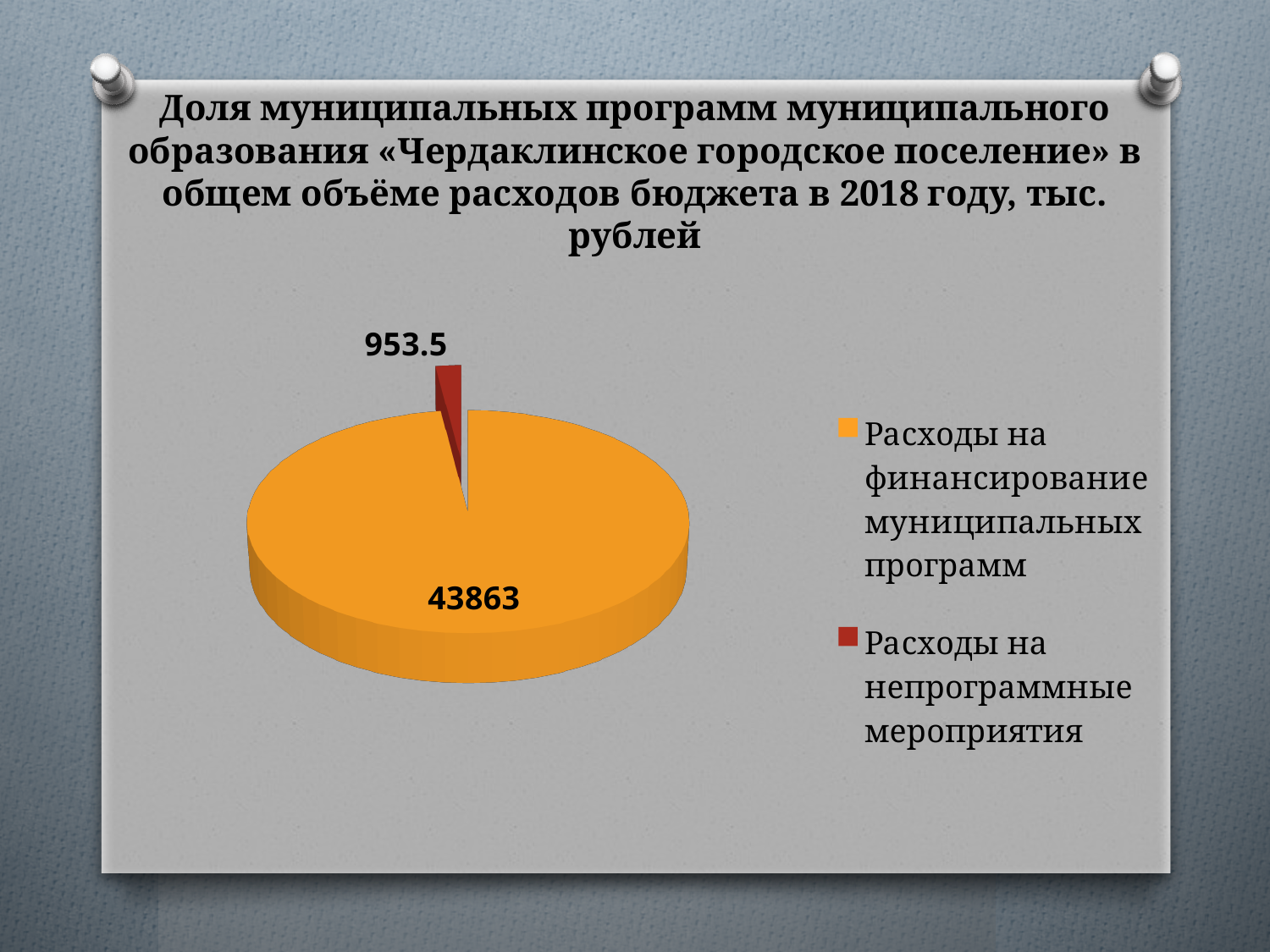
What is the total of the two values shown on the pie chart? 44816.5 Which is larger: the value for "Расходы на непрограммные мероприятия" or the value for "Расходы на финансирование муниципальных программ"? Расходы на финансирование муниципальных программ What is the value for "Расходы на непрограммные мероприятия"? 953.5 What colour is the slice for "Расходы на непрограммные мероприятия"? Red What is the value for "Расходы на финансирование муниципальных программ"? 43863 What type of chart is shown on the slide? Pie chart How many slices does the pie chart have? 2 Which category has the largest slice of the pie? Расходы на финансирование муниципальных программ What is the difference between the value for "Расходы на финансирование муниципальных программ" and the value for "Расходы на непрограммные мероприятия"? 42909.5 Which category has the smallest slice of the pie? Расходы на непрограммные мероприятия How many entries does the legend list? 2